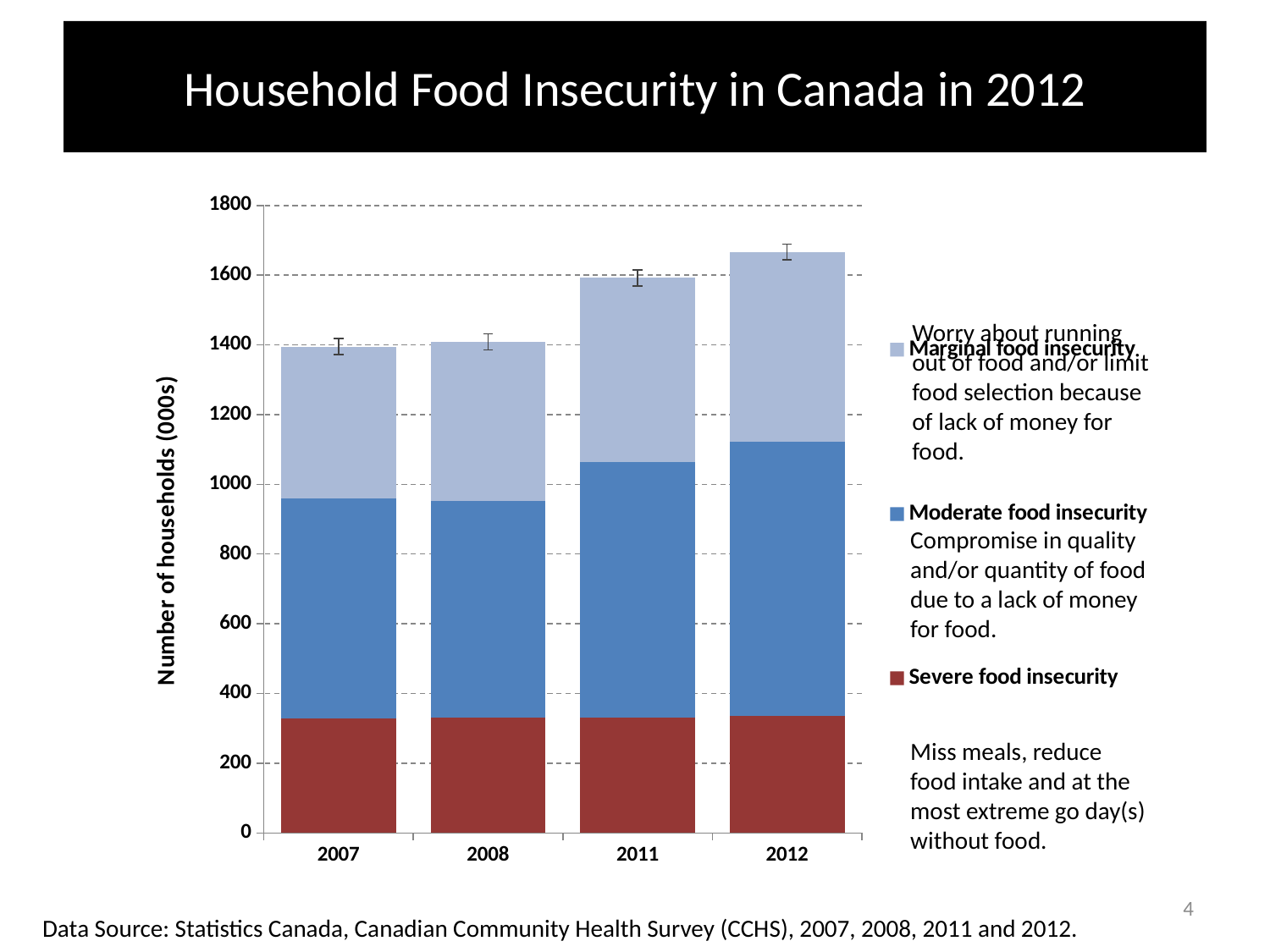
Which year has the larger total number of households, 2007 or 2012? 2012 Is the severe food insecurity segment for 2012 greater or less than 400? less Which year has the highest total number of food-insecure households? 2012 Do the total bar heights generally rise or fall from 2007 to 2012? rise Is the total number of households for 2007 greater or less than 1200? greater How many years are shown on the x axis of the chart? 4 Is the total number of households for 2012 greater or less than 1600? greater Which year has the larger total number of households, 2011 or 2012? 2012 What is the label of the y axis? Number of households (000s) What kind of chart is shown on the slide? Stacked bar chart How many series does the chart's legend list? 3